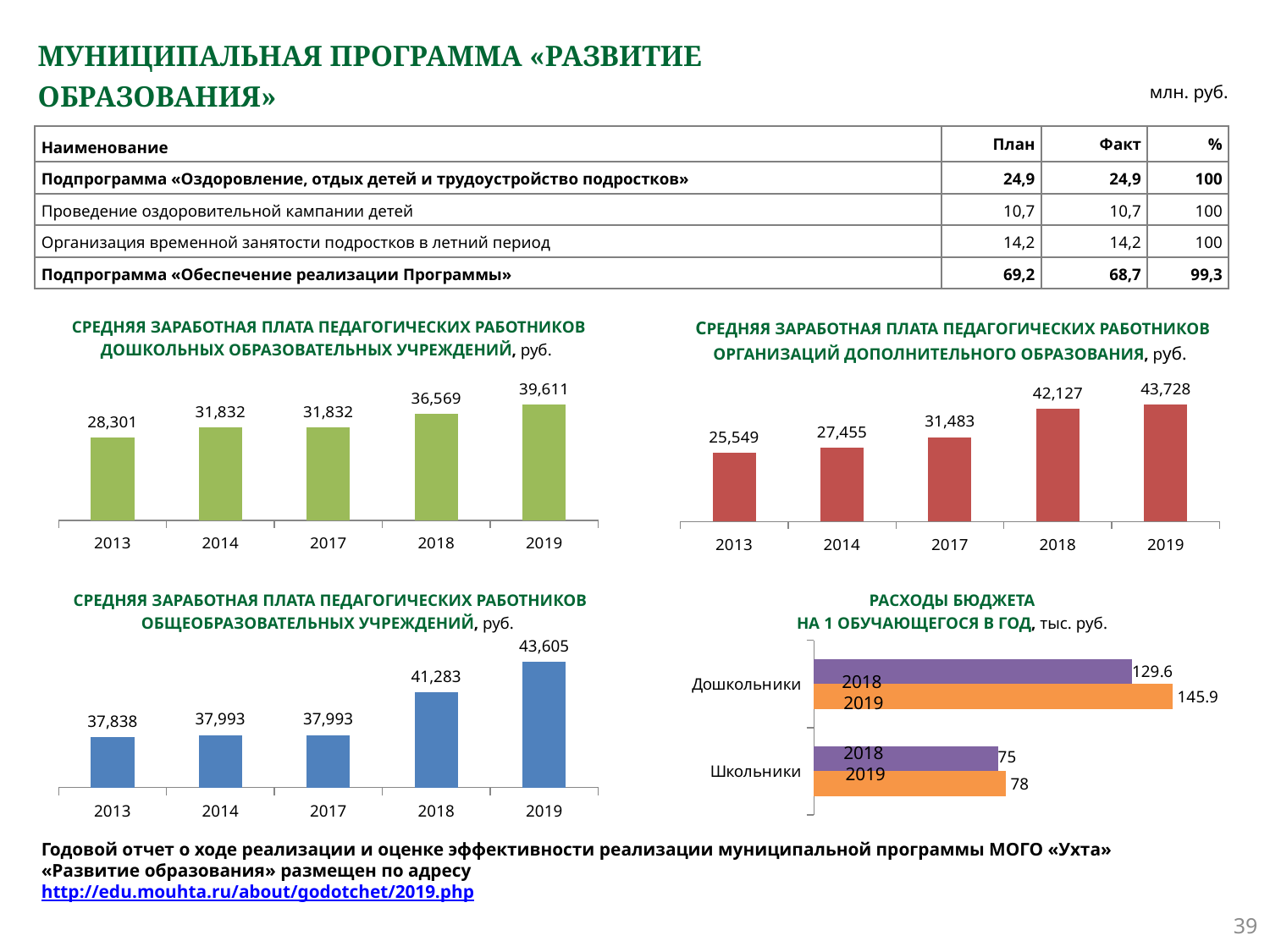
In the chart on average salary of teaching staff in preschool educational institutions (top left), what is the value for 2019? 39,611 In the chart on average salary of teaching staff in organizations of additional education (top right), what is the value for 2017? 31,483 In the chart on average salary of teaching staff in general education institutions (bottom left), how many years are shown on the x axis? 5 In the chart 'РАСХОДЫ БЮДЖЕТА НА 1 ОБУЧАЮЩЕГОСЯ В ГОД' (bottom right), which is larger for Школьники: 2018 or 2019? 2019 In the chart on average salary of teaching staff in preschool educational institutions (top left), what is the difference between the 2019 and 2018 values? 3,042 In the chart on average salary of teaching staff in organizations of additional education (top right), which year has the highest value? 2019 In the chart on average salary of teaching staff in general education institutions (bottom left), what is the difference between the 2018 and 2017 values? 3,290 In the chart on average salary of teaching staff in general education institutions (bottom left), what is the value for 2013? 37,838 In the chart on average salary of teaching staff in organizations of additional education (top right), do the values rise or fall from 2013 to 2019? rise In the chart on average salary of teaching staff in preschool educational institutions (top left), which year has the lowest value? 2013 In the chart 'РАСХОДЫ БЮДЖЕТА НА 1 ОБУЧАЮЩЕГОСЯ В ГОД' (bottom right), what is the value for Дошкольники in 2019? 145.9 What type of chart is 'РАСХОДЫ БЮДЖЕТА НА 1 ОБУЧАЮЩЕГОСЯ В ГОД' (bottom right)? bar chart